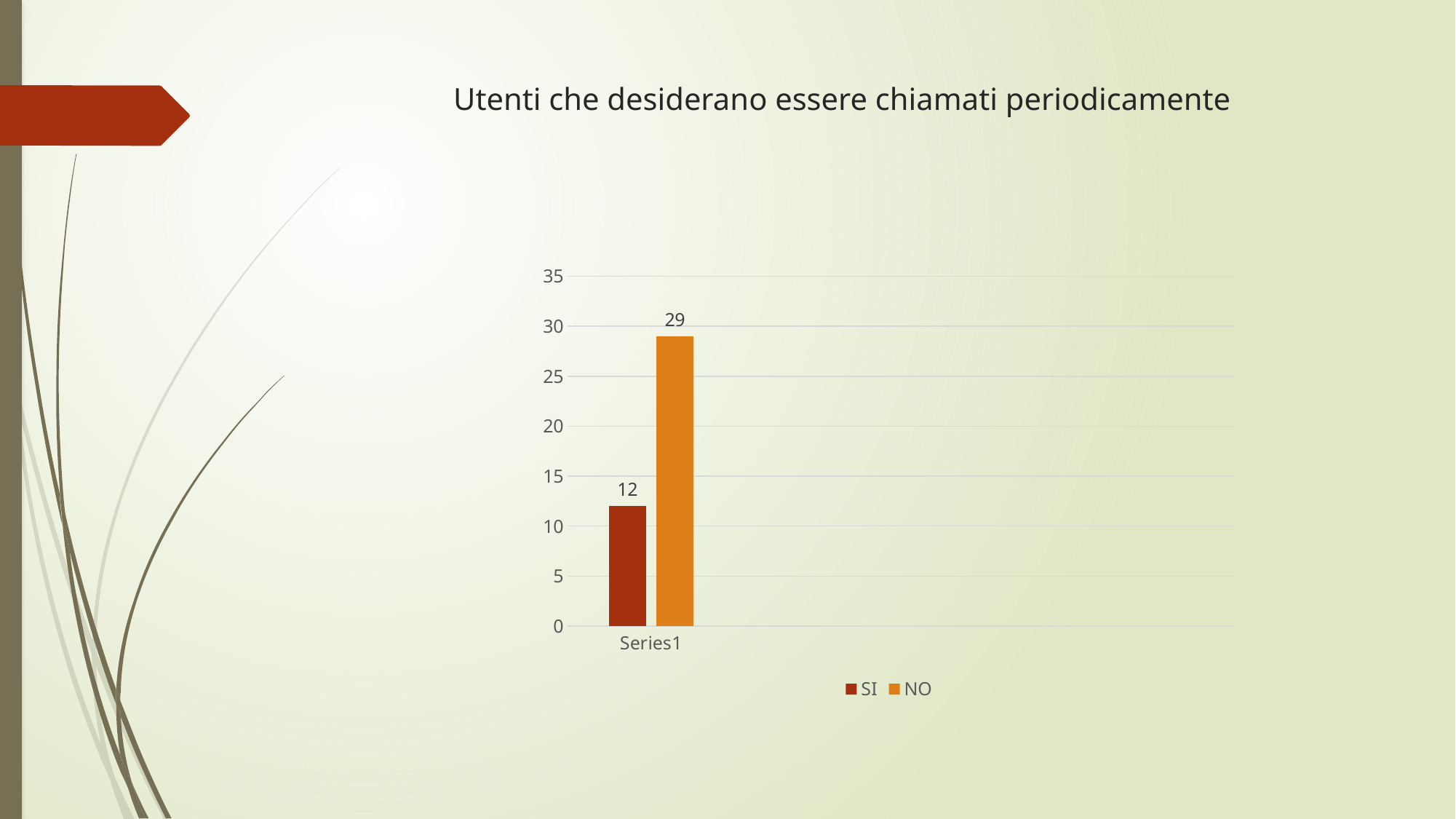
Which is larger, the value for SI or the value for NO? NO Is the value for SI greater or less than 15? less What is the value for NO? 29 Which series has the highest value? NO What is the title of the chart? Utenti che desiderano essere chiamati periodicamente Which series has the lowest value? SI What is the difference between the values for NO and SI? 17 What is the label on the x axis under the bars? Series1 How many series does the legend list? 2 What kind of chart is shown on the slide? bar chart Is the value for NO greater or less than 25? greater What is the value for SI? 12